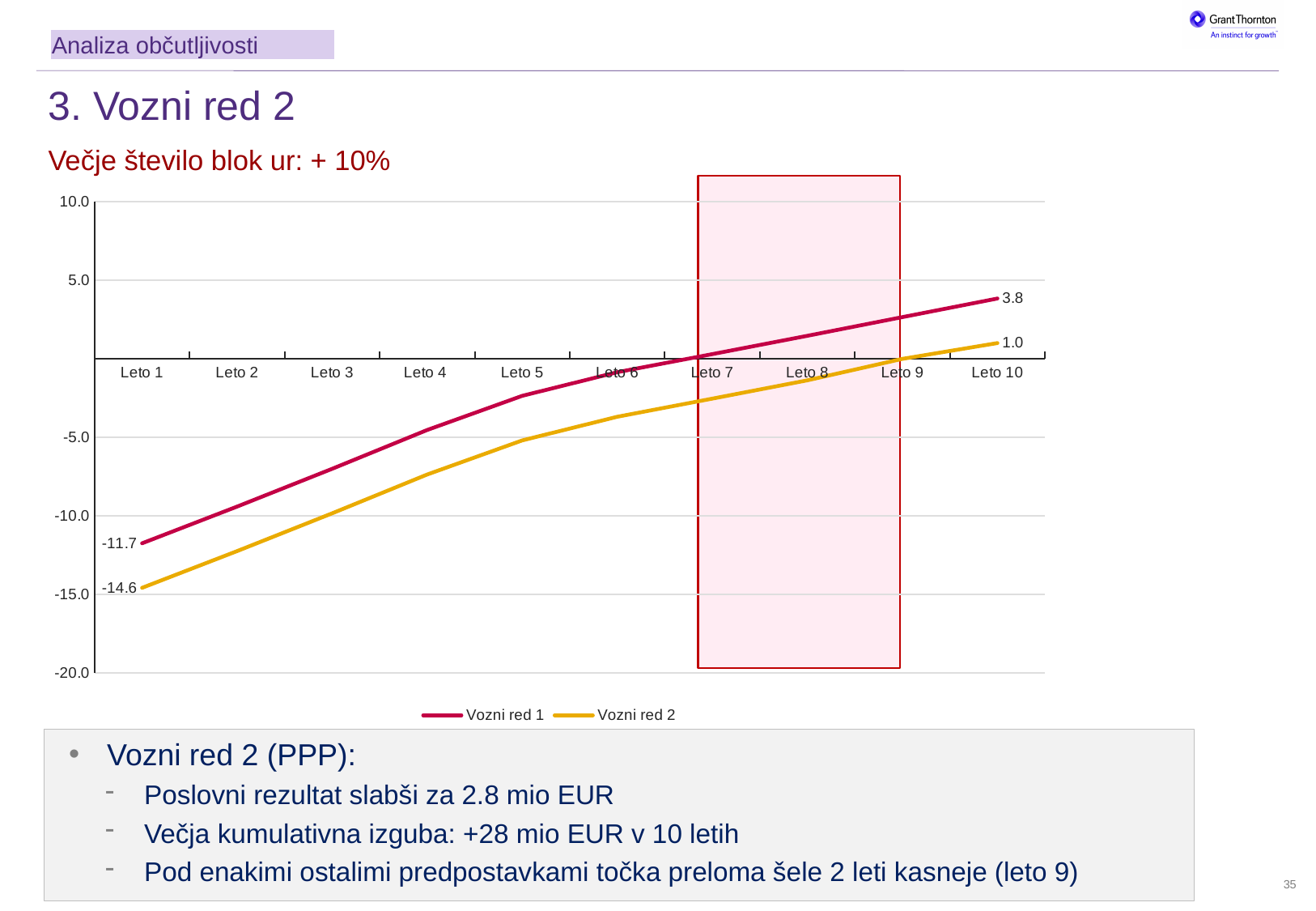
What kind of chart is shown on the slide? line chart Is the value for Vozni red 1 in Leto 3 greater or less than -5.0? less What is the value of Vozni red 1 in Leto 10? 3.8 How many years (categories) are shown on the x axis? 10 What is the value of Vozni red 2 in Leto 1? -14.6 By how much does Vozni red 1 change from Leto 1 to Leto 10? 15.6 What is the difference between Vozni red 1 and Vozni red 2 in Leto 1? 2.8 How many series does the legend list? 2 What is the difference between Vozni red 1 and Vozni red 2 in Leto 10? 2.8 What is the value of Vozni red 1 in Leto 1? -11.7 What is the value of Vozni red 2 in Leto 10? 1.0 Which series has the higher value in Leto 10, Vozni red 1 or Vozni red 2? Vozni red 1